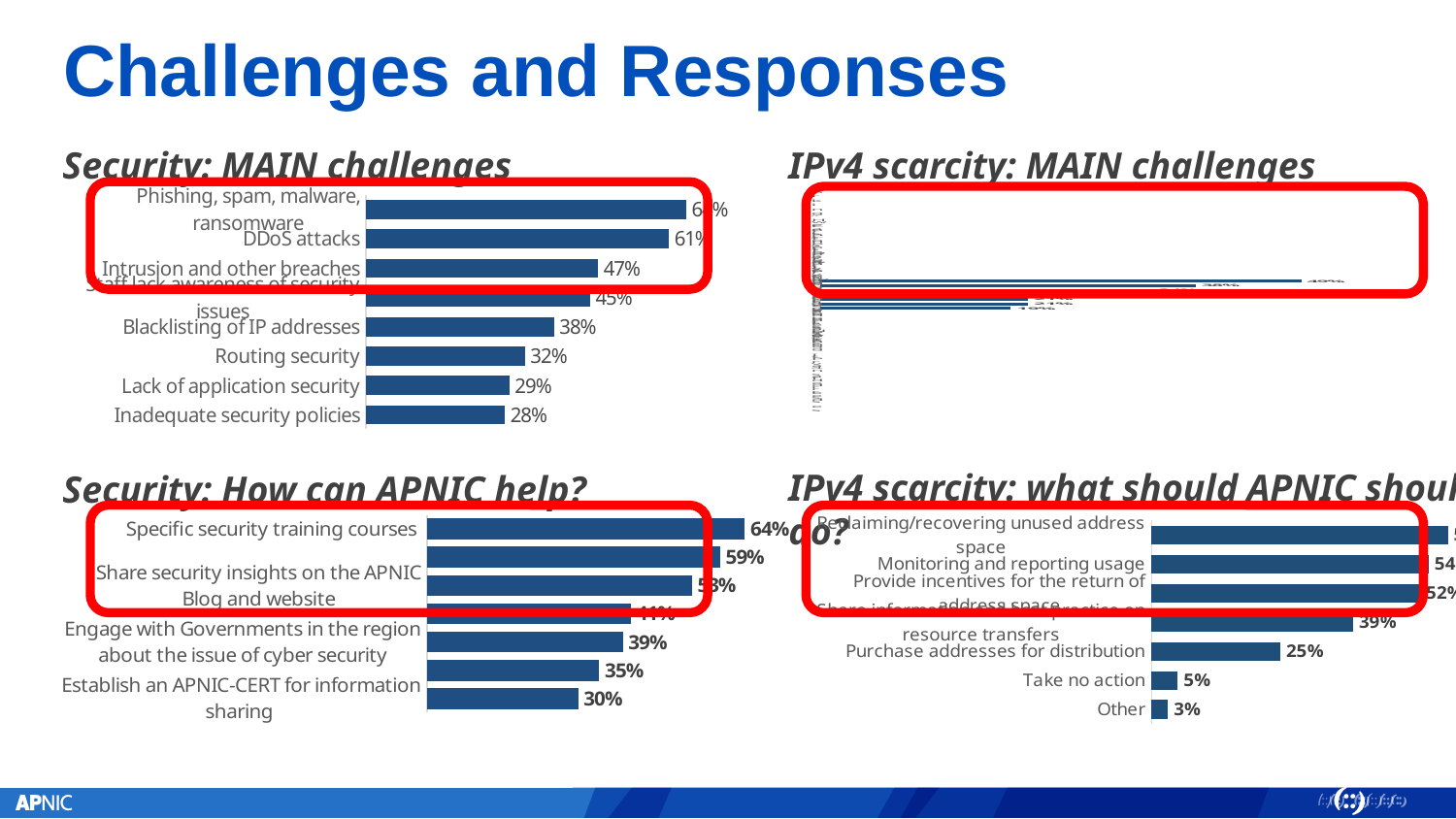
What type of chart is 'Security: MAIN challenges'? Bar chart In the 'Security: MAIN challenges' chart, which category has the lowest value? Inadequate security policies In the 'Security: How can APNIC help?' chart, what is the value for Specific security training courses? 64% In the 'Security: MAIN challenges' chart, what is the value for Blacklisting of IP addresses? 38% In the 'Security: MAIN challenges' chart, what is the difference between Routing security and Lack of application security? 3% How many categories are shown in the 'Security: MAIN challenges' chart? 8 In the 'IPv4 scarcity: what should APNIC should do?' chart, what is the difference between Take no action and Other? 2% In the 'Security: MAIN challenges' chart, what is the value for DDoS attacks? 61% In the 'Security: How can APNIC help?' chart, what is the value for Establish an APNIC-CERT for information sharing? 30% In the 'Security: MAIN challenges' chart, what is the value for Intrusion and other breaches? 47% In the 'IPv4 scarcity: what should APNIC should do?' chart, what is the value for Purchase addresses for distribution? 25% In the 'Security: MAIN challenges' chart, which is larger: DDoS attacks or Intrusion and other breaches? DDoS attacks